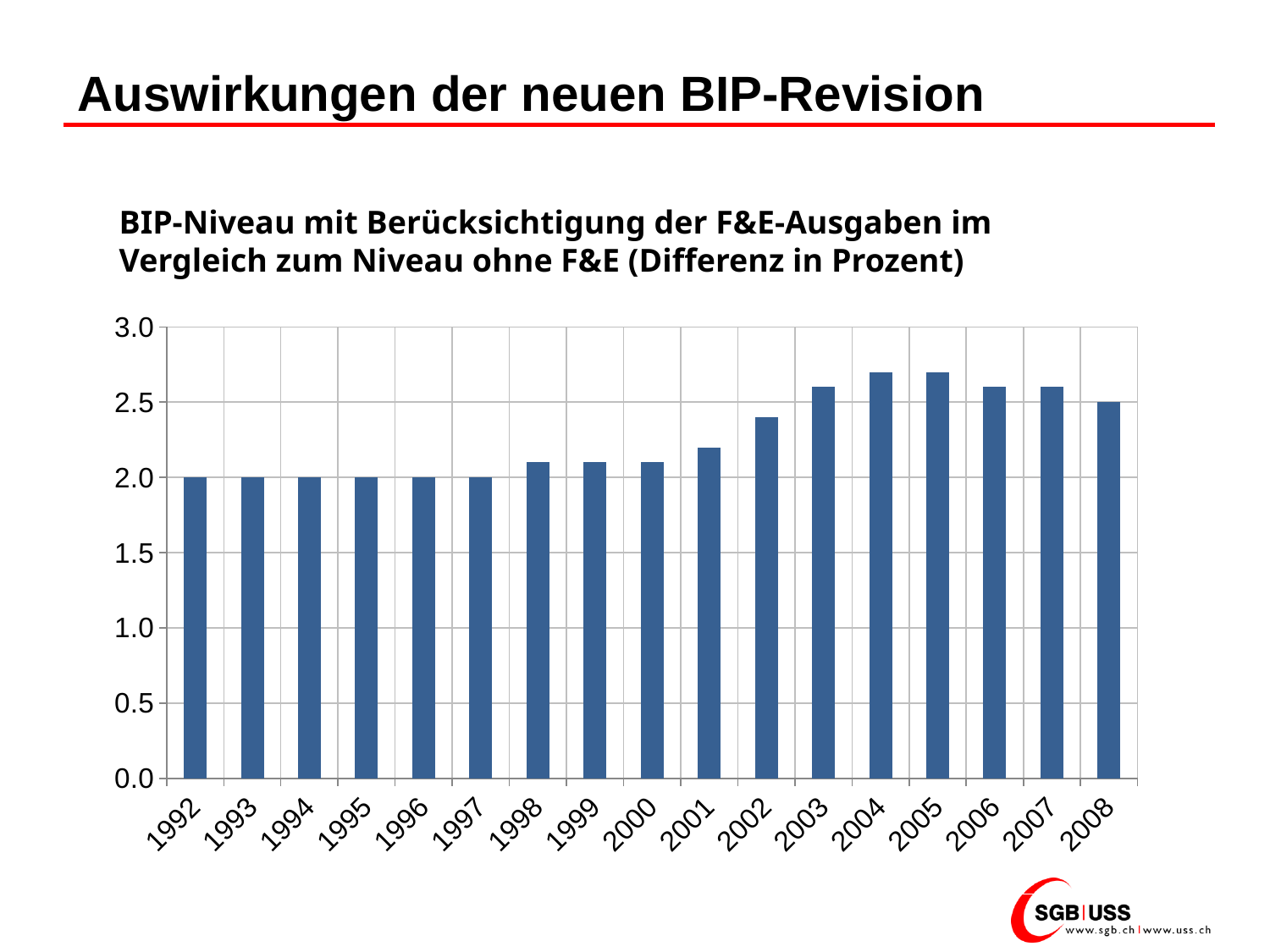
What type of chart is shown on the slide? bar chart Which is larger, the value for 2005 or the value for 2008? 2005 What is the value for 1992? 2.0 What is the first year shown on the x axis of the chart? 1992 Is the value for 2001 greater or less than 2.5? less Is the value for 2002 greater or less than 2.0? greater Do the values generally rise or fall from 1992 to 2005? rise How many years are shown on the x axis of the chart? 17 What is the value for 1997? 2.0 Is the value for 2004 greater or less than 2.5? greater Which is larger, the value for 2003 or the value for 1995? 2003 What is the value for 2008? 2.5